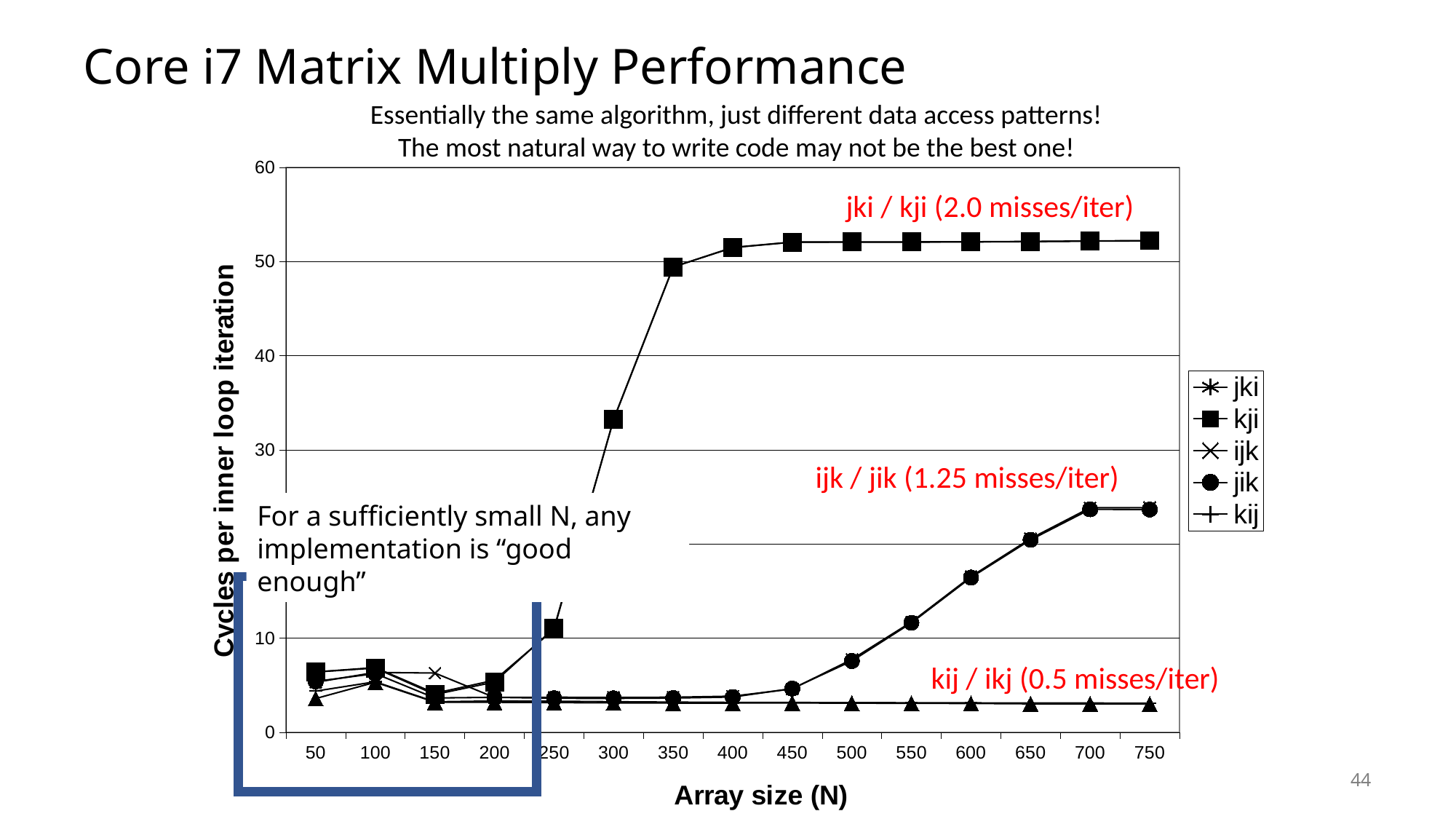
What is the title of the x axis? Array size (N) How many series does the legend list? 5 Does the kji series rise or fall as N increases from 250 to 750? rise What kind of chart is shown on the slide? line chart At N=750, which is larger, the value for kji or the value for kij? kji Is the value for kji at N=350 greater or less than 40? greater Is the value for jik at N=700 greater or less than 30? less How many array size values are marked along the x axis? 15 Is the value for kji at N=750 greater or less than 50? greater At N=500, which is larger, the value for jik or the value for kij? jik